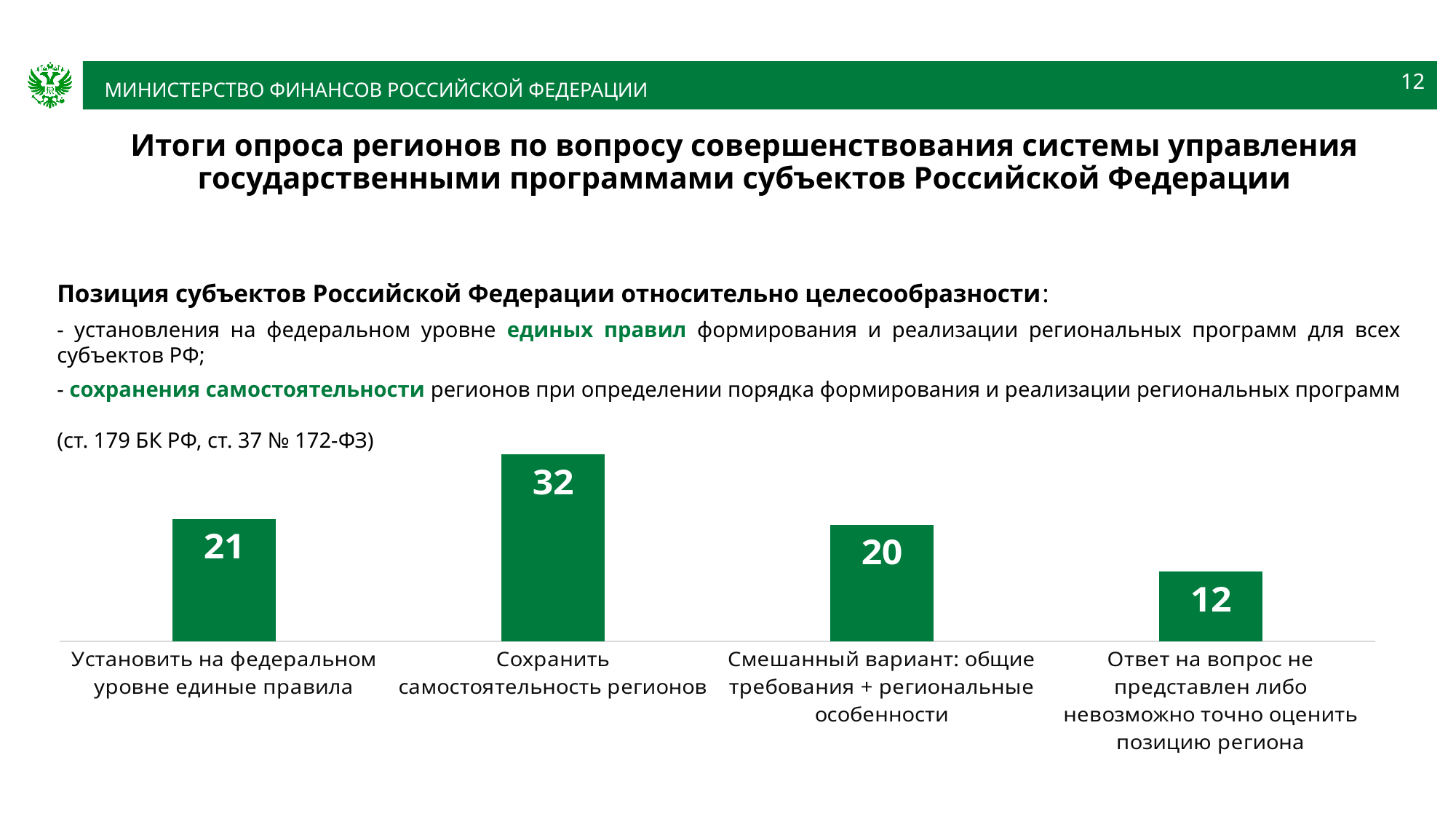
Which category has the lowest value? Ответ на вопрос не представлен либо невозможно точно оценить позицию региона What is the difference between the values for "Сохранить самостоятельность регионов" and "Установить на федеральном уровне единые правила"? 11 Which category has the highest value? Сохранить самостоятельность регионов What kind of chart is shown on the slide? Bar chart What is the value for "Смешанный вариант: общие требования + региональные особенности"? 20 What is the value for "Ответ на вопрос не представлен либо невозможно точно оценить позицию региона"? 12 What is the difference between the values for "Смешанный вариант: общие требования + региональные особенности" and "Ответ на вопрос не представлен либо невозможно точно оценить позицию региона"? 8 What is the value for "Сохранить самостоятельность регионов"? 32 What is the value for "Установить на федеральном уровне единые правила"? 21 Which is larger: the value for "Установить на федеральном уровне единые правила" or for "Смешанный вариант: общие требования + региональные особенности"? Установить на федеральном уровне единые правила What is the total of all four values shown in the chart? 85 How many categories are shown in the chart? 4